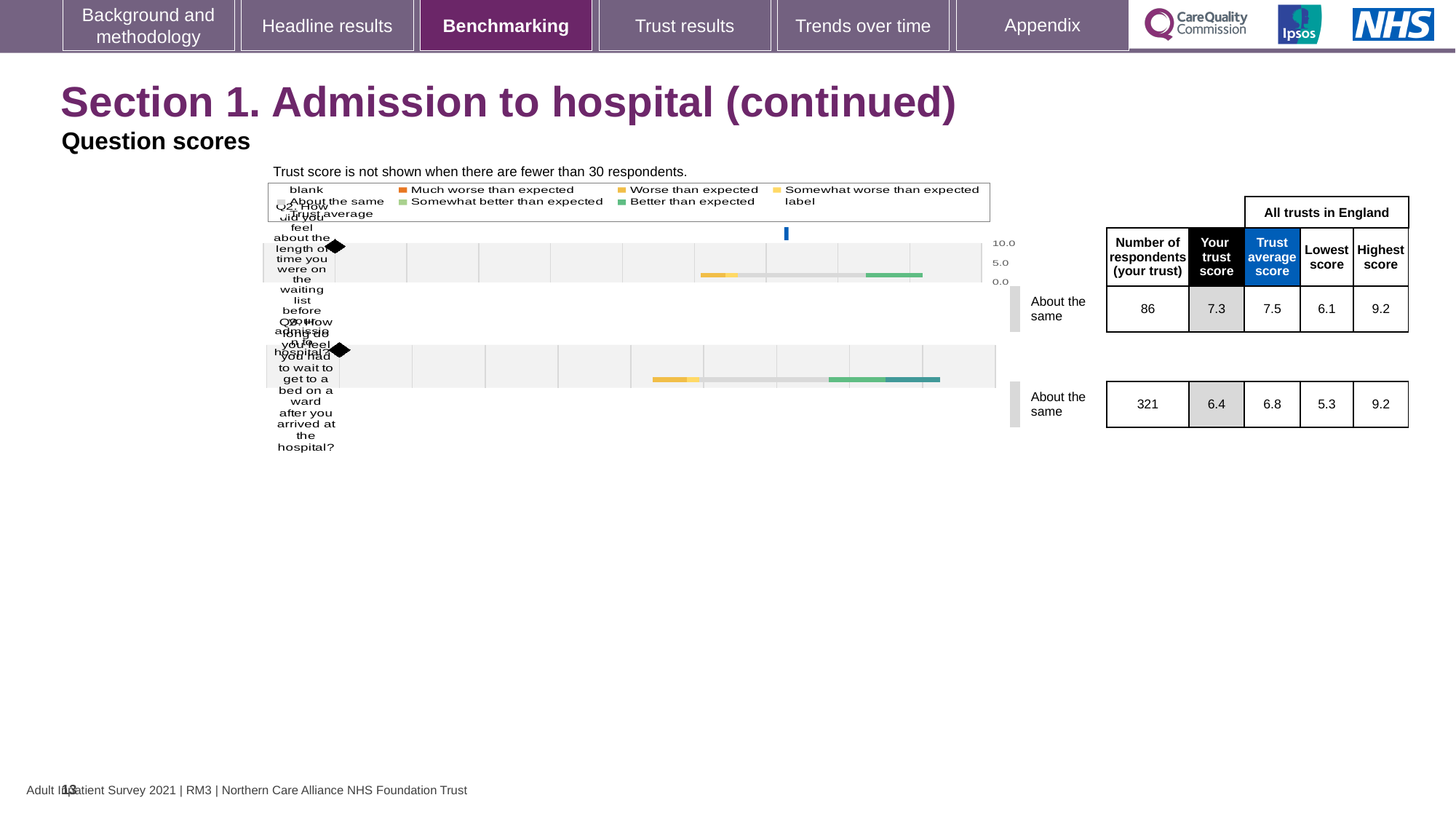
What is the maximum value shown on the score axis of the charts? 10.0 What benchmark category is this trust's score for Q2 placed in? About the same Which question has the lower 'Lowest score' among all trusts in England, Q2 or Q3? Q3 What is the difference between the trust average score and this trust's score for Q3? 0.4 What is the trust average score across all trusts in England for Q2? 7.5 How many respondents from the trust answered Q3 (wait to get to a bed on a ward)? 321 For Q3 (wait to get to a bed on a ward after arriving at the hospital), what is the trust score shown in the 'Your trust score' column? 6.4 What is the highest score among all trusts in England for Q3? 9.2 How many respondents from the trust answered Q2 (length of time on the waiting list)? 86 What kind of chart is used to show the question scores on this slide? Bar chart For Q2 (length of time on the waiting list before admission), what is the trust score shown in the 'Your trust score' column? 7.3 Which question has the higher trust score for this trust, Q2 or Q3? Q2